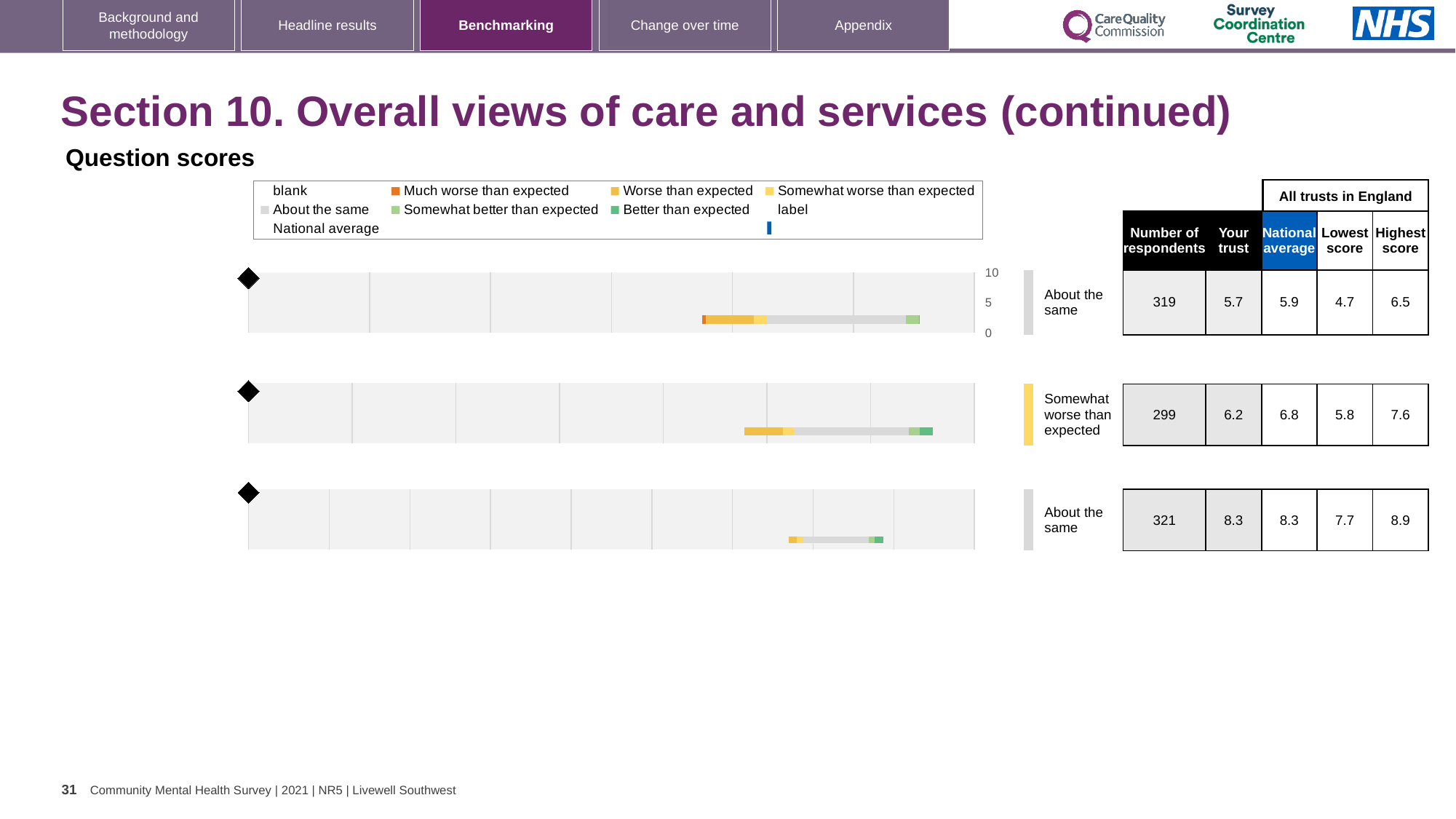
For the bottom chart, which is larger: the 'Your trust' score or the national average? They are equal (8.3) For the top chart, what is the national average score? 5.9 For the top chart, what is the 'Your trust' score? 5.7 What kind of chart is used for the three benchmarking charts on the slide? bar chart For the middle chart, what is the 'Your trust' score? 6.2 For the top chart, what is the number of respondents shown in the table? 319 How many benchmarking charts are shown on the slide? 3 For the bottom chart, what is the lowest score among all trusts in England? 7.7 What is the maximum value shown on the vertical axis of the top chart? 10 For the middle chart, what is the difference between the national average and the 'Your trust' score? 0.6 What benchmark rating label is shown next to the middle chart? Somewhat worse than expected For the middle chart, what is the highest score among all trusts in England? 7.6